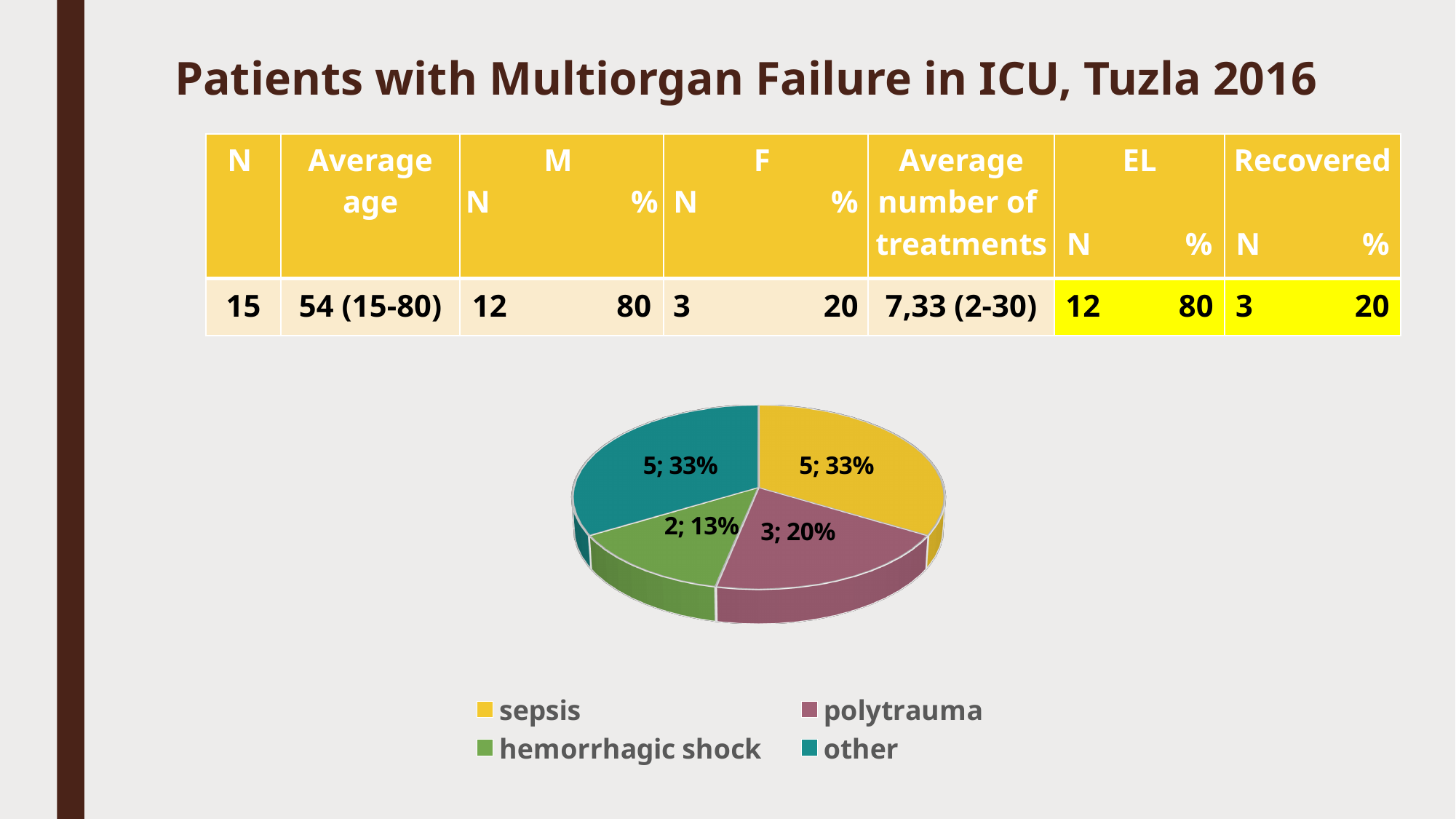
Which colour represents polytrauma in the pie chart legend? purple What kind of chart is shown on the slide? pie chart How many slices does the pie chart have? 4 What percentage does the polytrauma slice represent in the pie chart? 20% Which category has the smallest slice in the pie chart? hemorrhagic shock What is the number of patients in the hemorrhagic shock slice of the pie chart? 2 Which slice is larger in the pie chart, polytrauma or hemorrhagic shock? polytrauma How many entries does the legend of the pie chart list? 4 What percentage does the 'other' slice represent in the pie chart? 33% What percentage does the hemorrhagic shock slice represent in the pie chart? 13% What is the difference in number of patients between the sepsis slice and the polytrauma slice in the pie chart? 2 What is the number of patients in the sepsis slice of the pie chart? 5